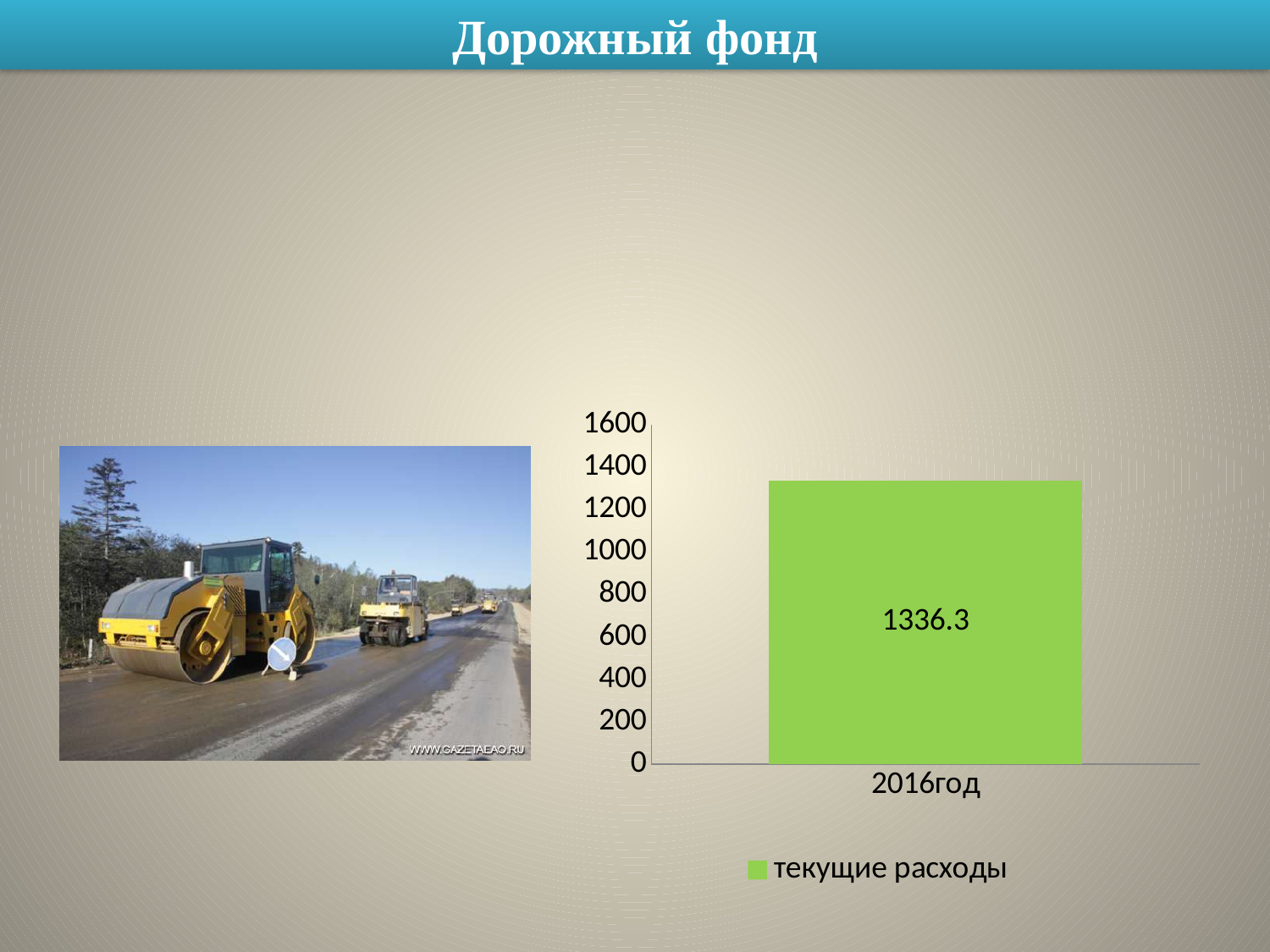
What is the value for 2016год in the chart? 1336.3 What colour is the bar in the chart? green Is the value for 2016год greater or less than 1400? less How many series does the chart legend list? 1 Is the value for 2016год greater or less than 1200? greater What is the name of the series shown in the chart legend? текущие расходы What kind of chart is shown on the slide? bar chart How many categories are shown on the x axis of the chart? 1 What is the category label on the x axis of the chart? 2016год What is the highest value shown on the vertical axis of the chart? 1600